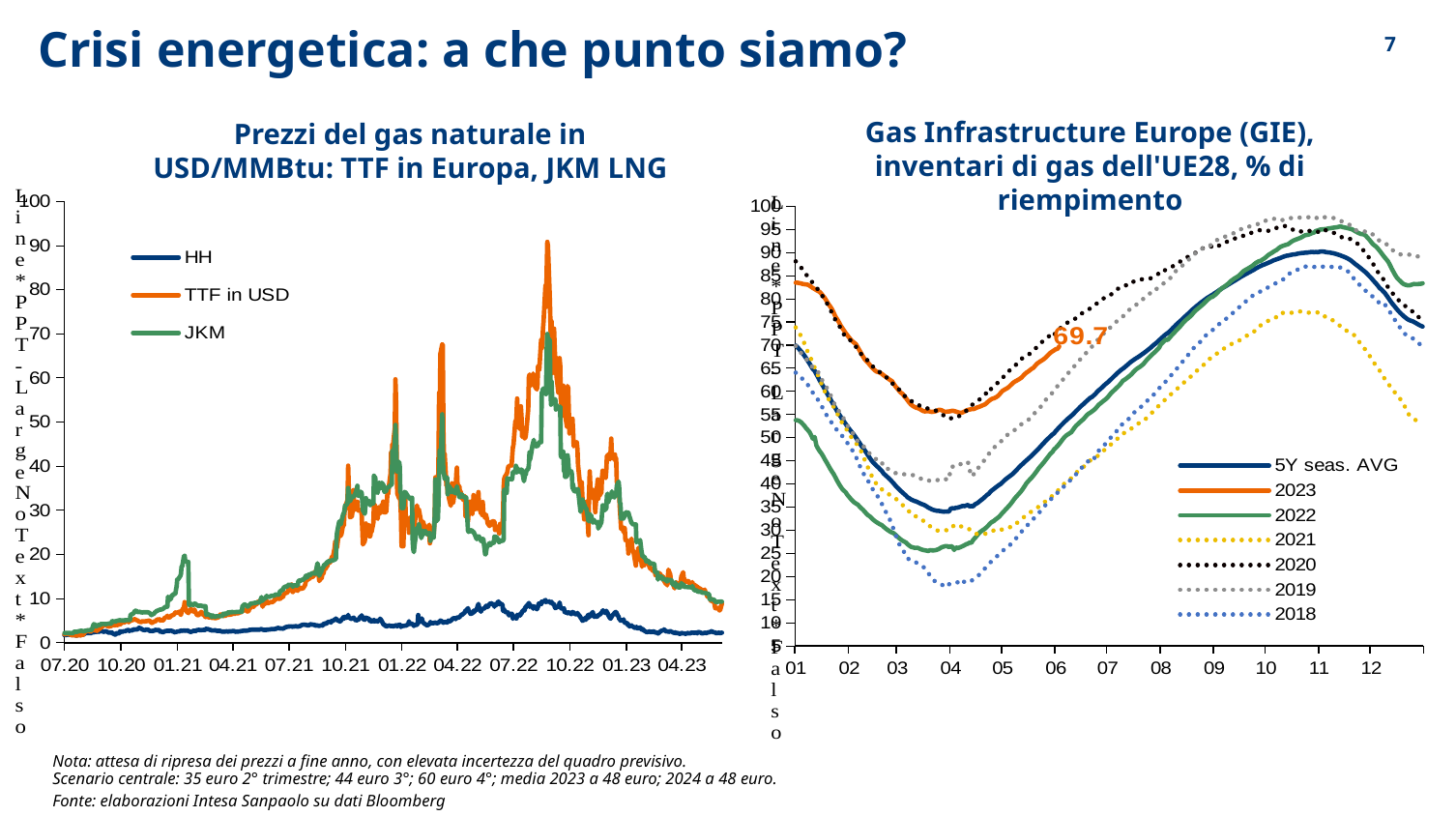
In the left chart ('Prezzi del gas naturale'), is the HH series ever greater or less than 20 over the period shown? less In the right chart ('Gas Infrastructure Europe (GIE)'), is the value of the 2022 series at month 01 greater or less than 60? less In the right chart ('Gas Infrastructure Europe (GIE)'), what is the value printed as a data label on the 2023 series? 69.7 In the right chart ('Gas Infrastructure Europe (GIE)'), at month 04, which is larger: the 2020 series or the 2018 series? 2020 In the left chart ('Prezzi del gas naturale'), does the TTF in USD series rise or fall between 10.22 and 07.23? fall How many series does the legend of the left chart ('Prezzi del gas naturale') list? 3 In the right chart ('Gas Infrastructure Europe (GIE)'), how many months are labelled on the x axis? 12 How many series does the legend of the right chart ('Gas Infrastructure Europe (GIE)') list? 7 What kind of chart is the left chart, 'Prezzi del gas naturale in USD/MMBtu'? line chart In the left chart ('Prezzi del gas naturale'), is the peak value of TTF in USD greater or less than 80? greater In the left chart ('Prezzi del gas naturale'), which series stays lowest across the whole period? HH In the right chart ('Gas Infrastructure Europe (GIE)'), which series is lowest at month 04? 2018